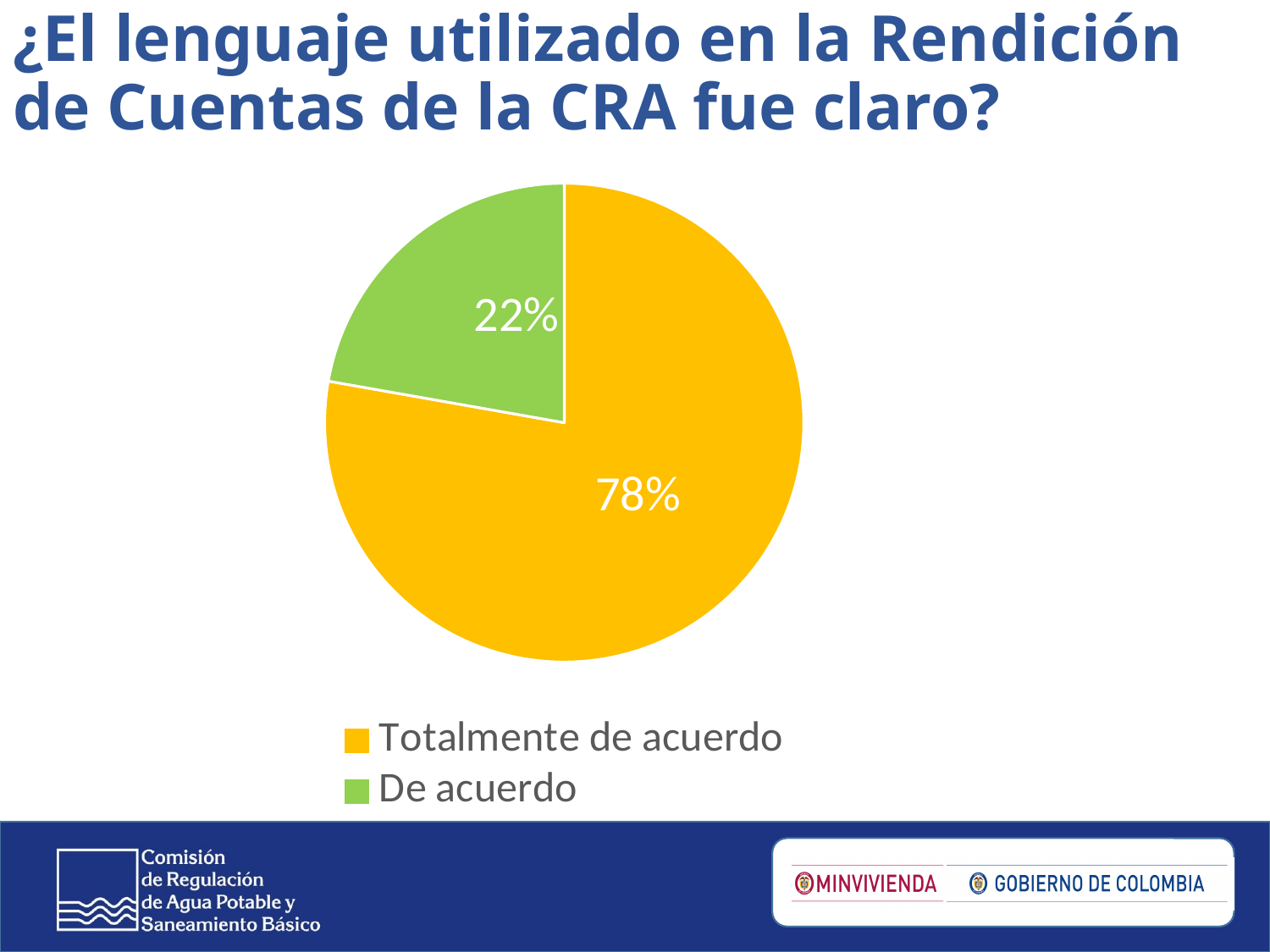
What percentage of respondents answered "De acuerdo"? 22% Which is larger: the share for "Totalmente de acuerdo" or the share for "De acuerdo"? Totalmente de acuerdo What is the difference in percentage points between "Totalmente de acuerdo" and "De acuerdo"? 56 What colour is the slice for "De acuerdo"? green How many categories does the pie chart show? 2 Which response category has the smallest share of the pie? De acuerdo How many entries does the legend list? 2 What kind of chart is shown on the slide? pie chart What colour is the slice for "Totalmente de acuerdo"? yellow Which response category has the largest share of the pie? Totalmente de acuerdo What is the combined share of the two slices shown in the pie chart? 100% What percentage of respondents answered "Totalmente de acuerdo"? 78%